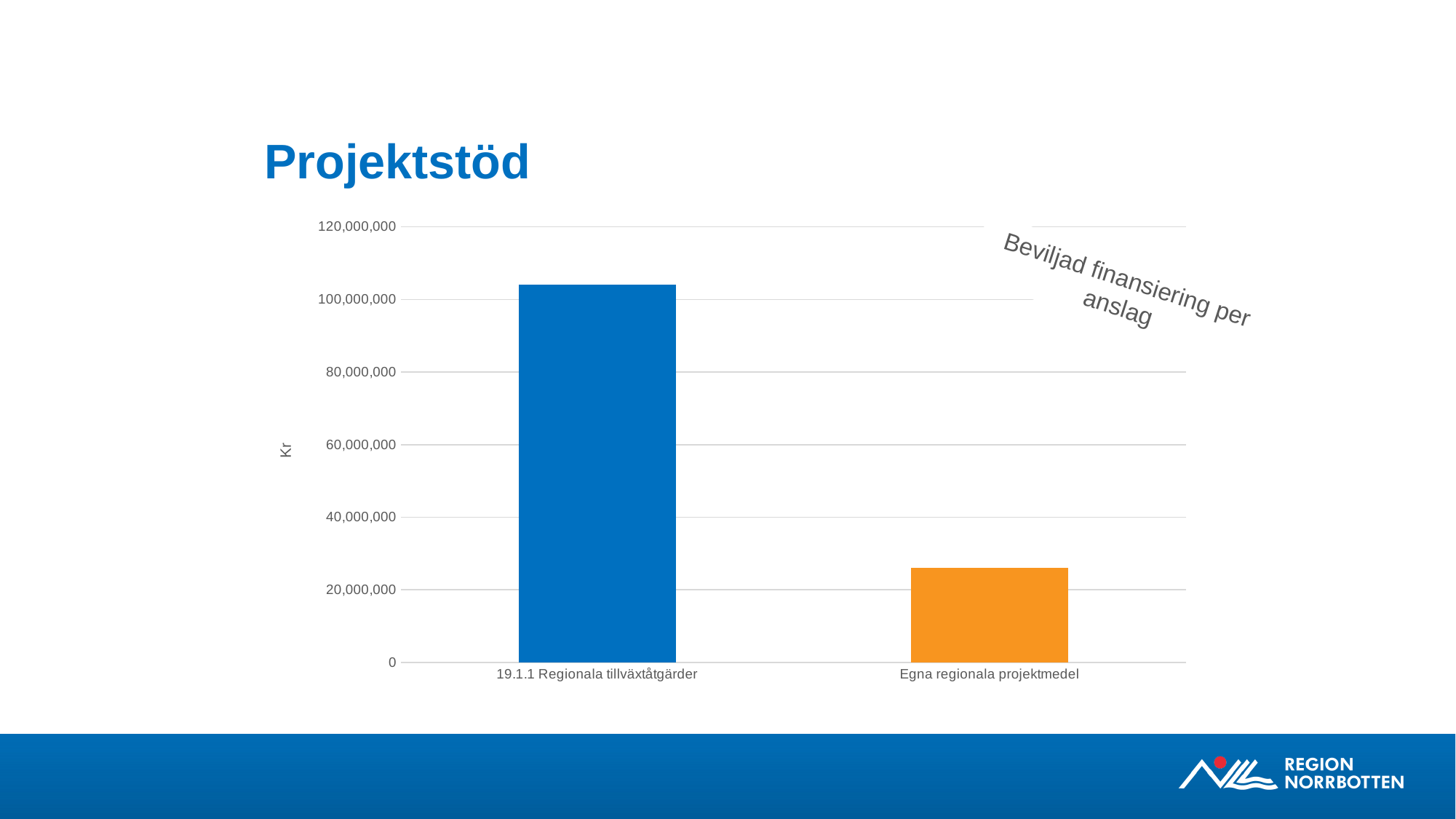
How many categories are shown on the x axis of the chart? 2 What kind of chart is shown on the slide? bar chart Is the value for 19.1.1 Regionala tillväxtåtgärder greater or less than 80,000,000? greater Is the value for 19.1.1 Regionala tillväxtåtgärder greater or less than 120,000,000? less Which category has the lowest value in the chart? Egna regionala projektmedel Which category has the highest value in the chart? 19.1.1 Regionala tillväxtåtgärder What text is written in the upper right of the chart area? Beviljad finansiering per anslag Is the value for Egna regionala projektmedel greater or less than 40,000,000? less Which is larger, the value for 19.1.1 Regionala tillväxtåtgärder or the value for Egna regionala projektmedel? 19.1.1 Regionala tillväxtåtgärder What is the label on the vertical axis of the chart? Kr